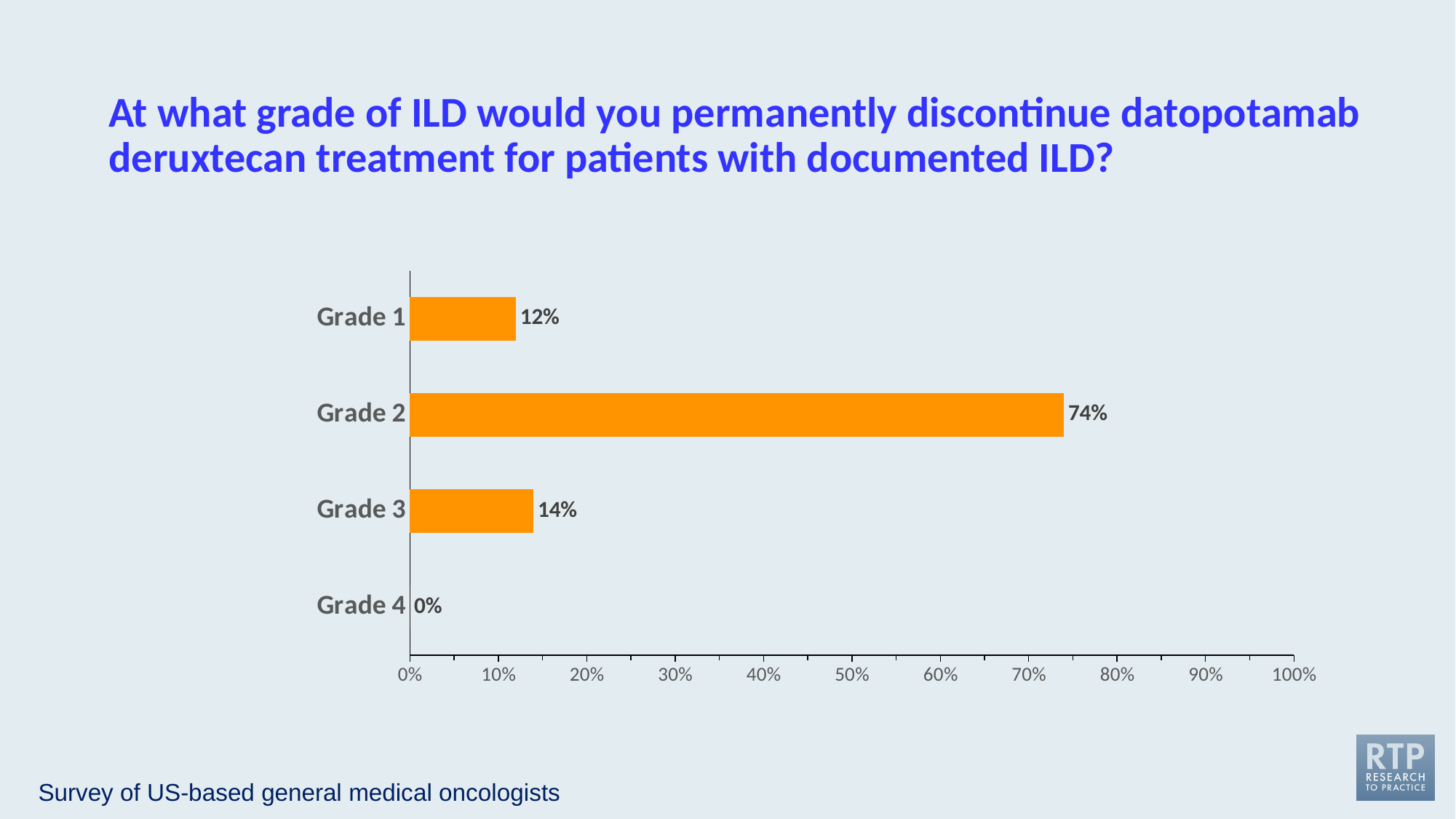
Which grade has the highest percentage? Grade 2 Which has a larger value, Grade 1 or Grade 2? Grade 2 Which grade has the lowest percentage? Grade 4 What is the value shown for Grade 3? 14% What type of chart is shown on the slide? Bar chart What is the difference between the values for Grade 3 and Grade 1? 2% What is the value shown for Grade 4? 0% Is the value for Grade 2 greater or less than 70%? greater How many grade categories are shown in the chart? 4 What percentage of respondents chose Grade 2? 74% What is the value shown for Grade 1? 12% What is the difference between the values for Grade 2 and Grade 3? 60%